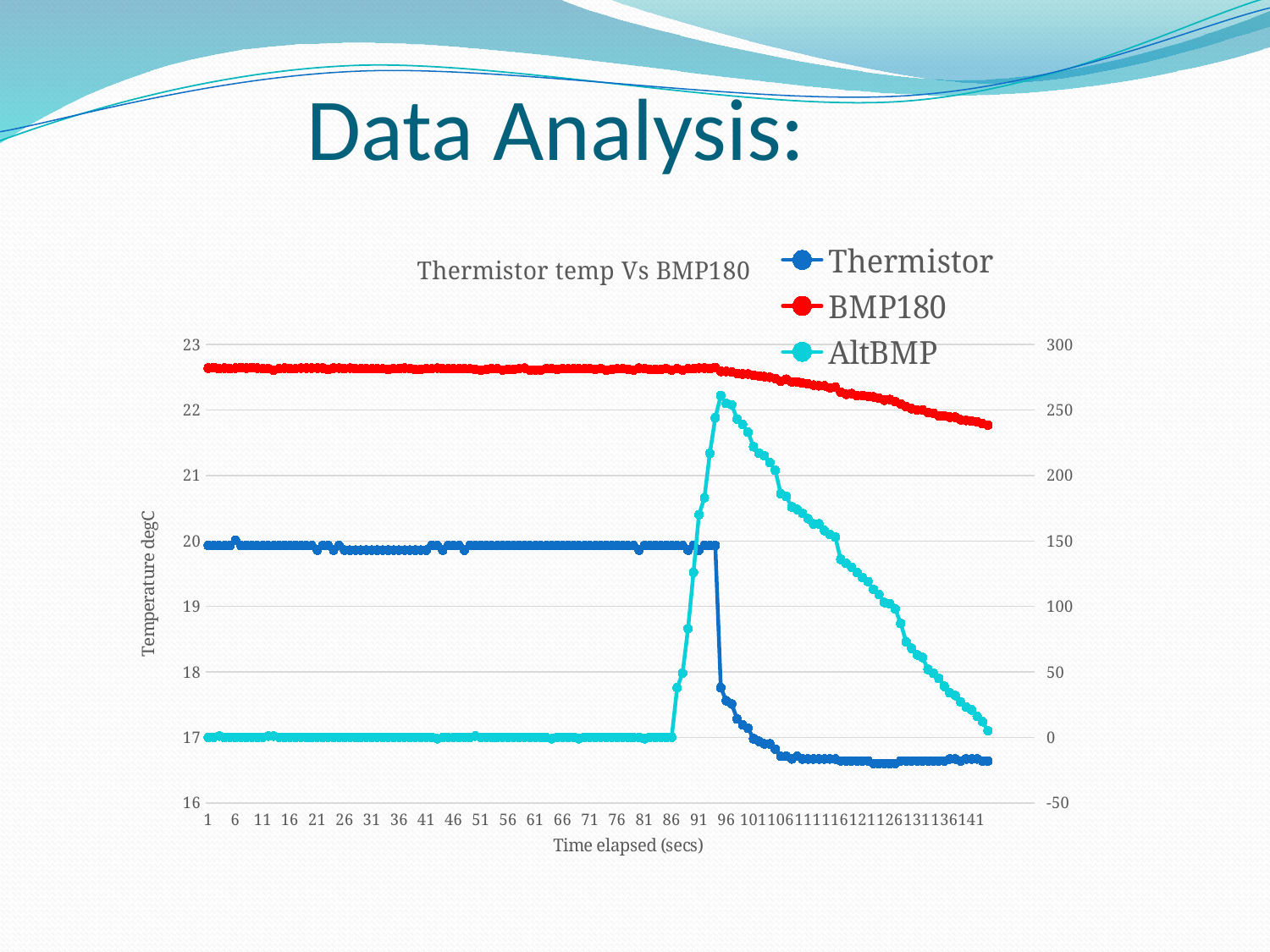
What is the title of the chart? Thermistor temp Vs BMP180 On the right-hand axis, is the AltBMP value at time 1 greater or less than 50? less Is the Thermistor value at time 1 greater or less than 19? greater What is the label of the x axis? Time elapsed (secs) At time 1, which series has the higher temperature, Thermistor or BMP180? BMP180 Is the BMP180 value at time 141 greater or less than 22? less How many series does the legend list? 3 Does the BMP180 series rise or fall from the start to the end of the time axis? fall What kind of chart is shown on the slide? line chart